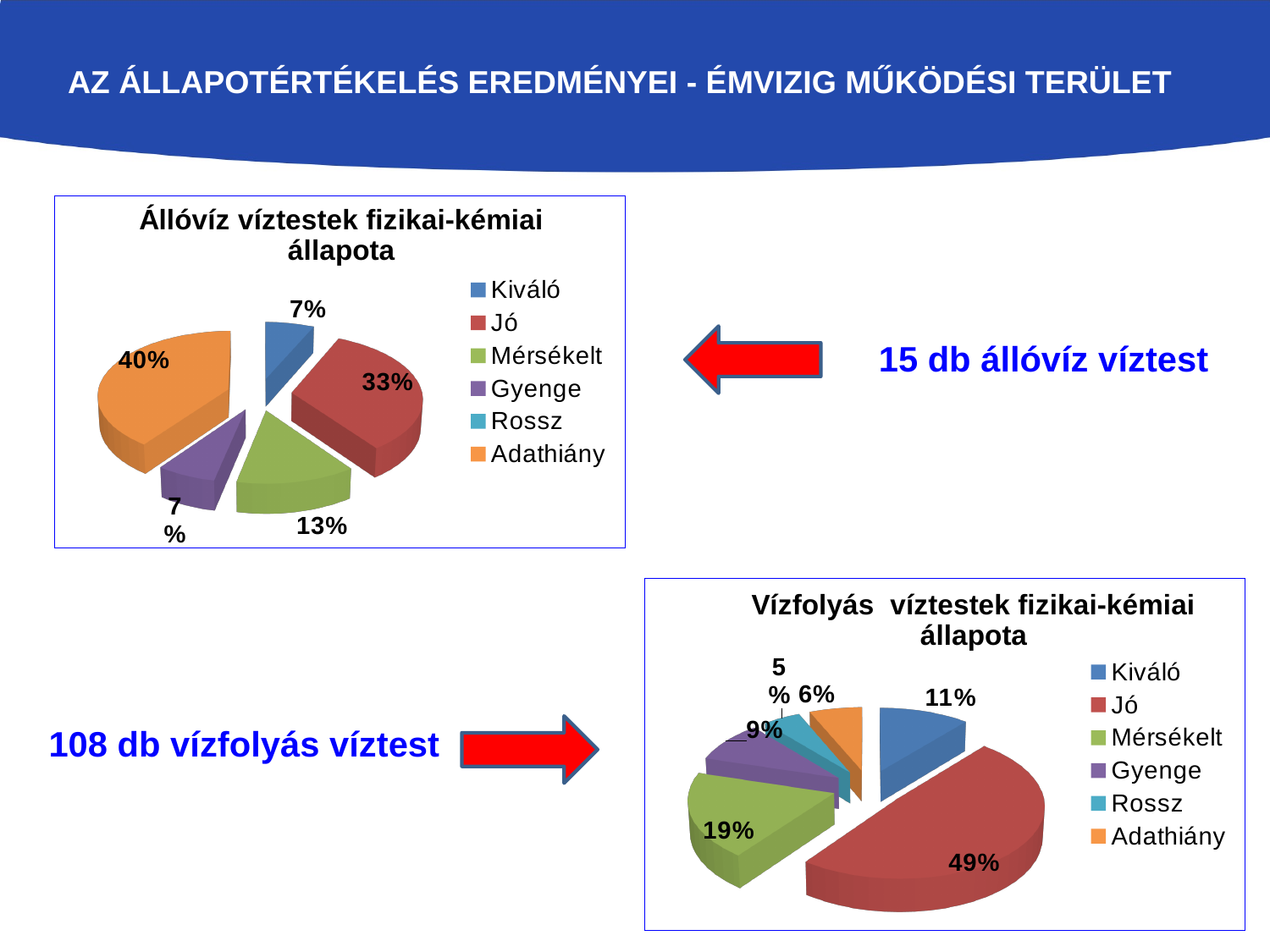
In the chart titled "Vízfolyás víztestek fizikai-kémiai állapota", what share does Mérsékelt have? 19% In the chart titled "Állóvíz víztestek fizikai-kémiai állapota", what share does Adathiány have? 40% In the chart titled "Vízfolyás víztestek fizikai-kémiai állapota", what share does Jó have? 49% In the chart titled "Állóvíz víztestek fizikai-kémiai állapota", which category has the largest slice? Adathiány In the chart titled "Vízfolyás víztestek fizikai-kémiai állapota", which is larger, Kiváló or Gyenge? Kiváló In the chart titled "Állóvíz víztestek fizikai-kémiai állapota", what share does Jó have? 33% In the chart titled "Vízfolyás víztestek fizikai-kémiai állapota", what share does Rossz have? 5% In the chart titled "Vízfolyás víztestek fizikai-kémiai állapota", what colour is the Jó slice? Red What kind of chart is "Vízfolyás víztestek fizikai-kémiai állapota"? Pie chart In the chart titled "Vízfolyás víztestek fizikai-kémiai állapota", which category has the smallest slice? Rossz In the chart titled "Állóvíz víztestek fizikai-kémiai állapota", how many entries does the legend list? 6 In the chart titled "Állóvíz víztestek fizikai-kémiai állapota", what is the difference between the Jó and Mérsékelt shares? 20%